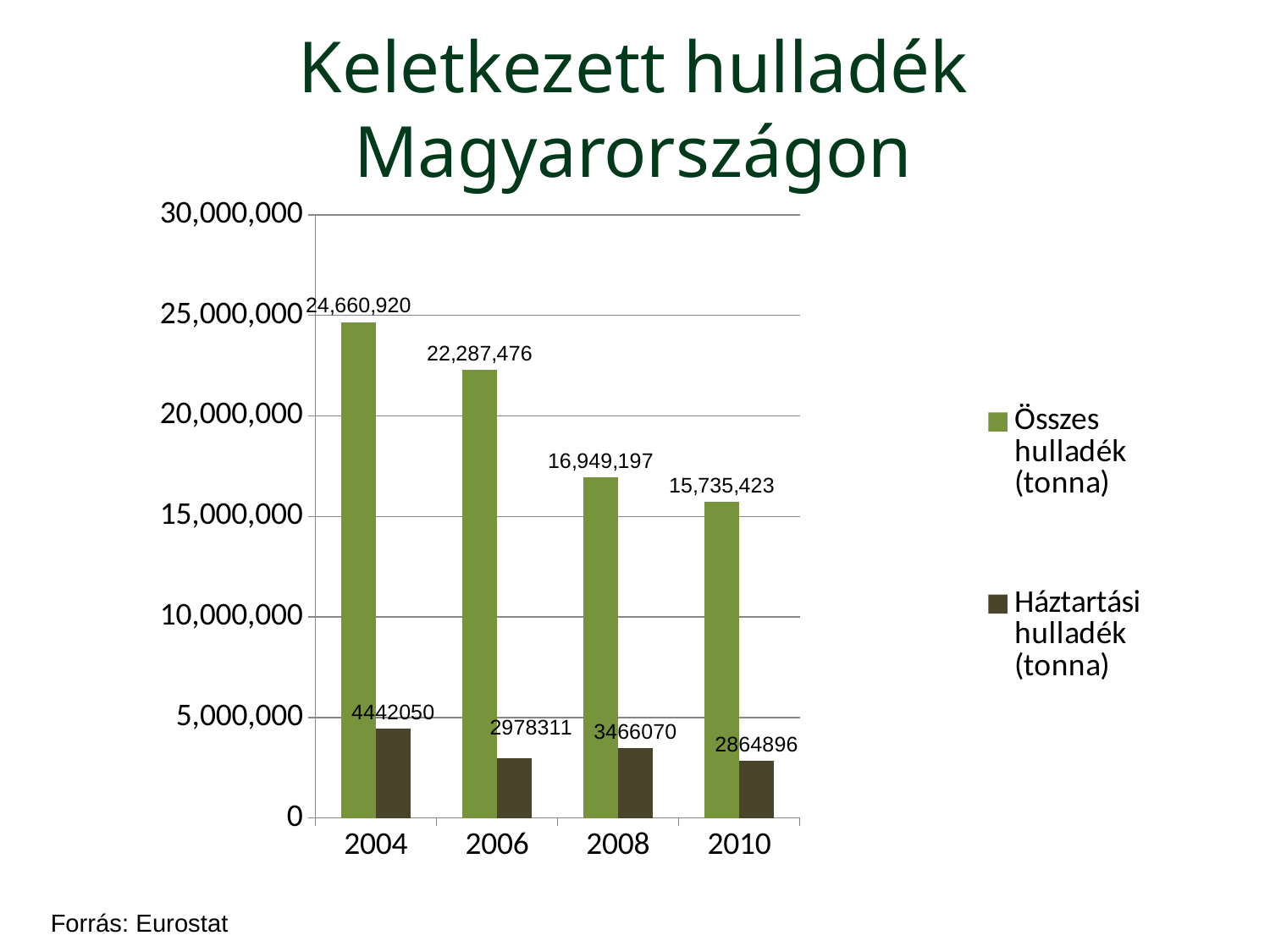
What is the value of Háztartási hulladék (tonna) for 2006? 2978311 What is the value of Összes hulladék (tonna) for 2004? 24,660,920 Is the value of Összes hulladék (tonna) for 2008 greater or less than 20,000,000? less In which year is Háztartási hulladék (tonna) highest? 2004 Which is larger: Háztartási hulladék (tonna) in 2006 or in 2008? 2008 How many series does the legend list? 2 What is the value of Összes hulladék (tonna) for 2010? 15,735,423 In which year is Összes hulladék (tonna) lowest? 2010 Does Összes hulladék (tonna) rise or fall from 2004 to 2010? fall What is the difference between Összes hulladék (tonna) in 2004 and in 2006? 2,373,444 How many years are shown on the x axis? 4 What kind of chart is shown on the slide? bar chart